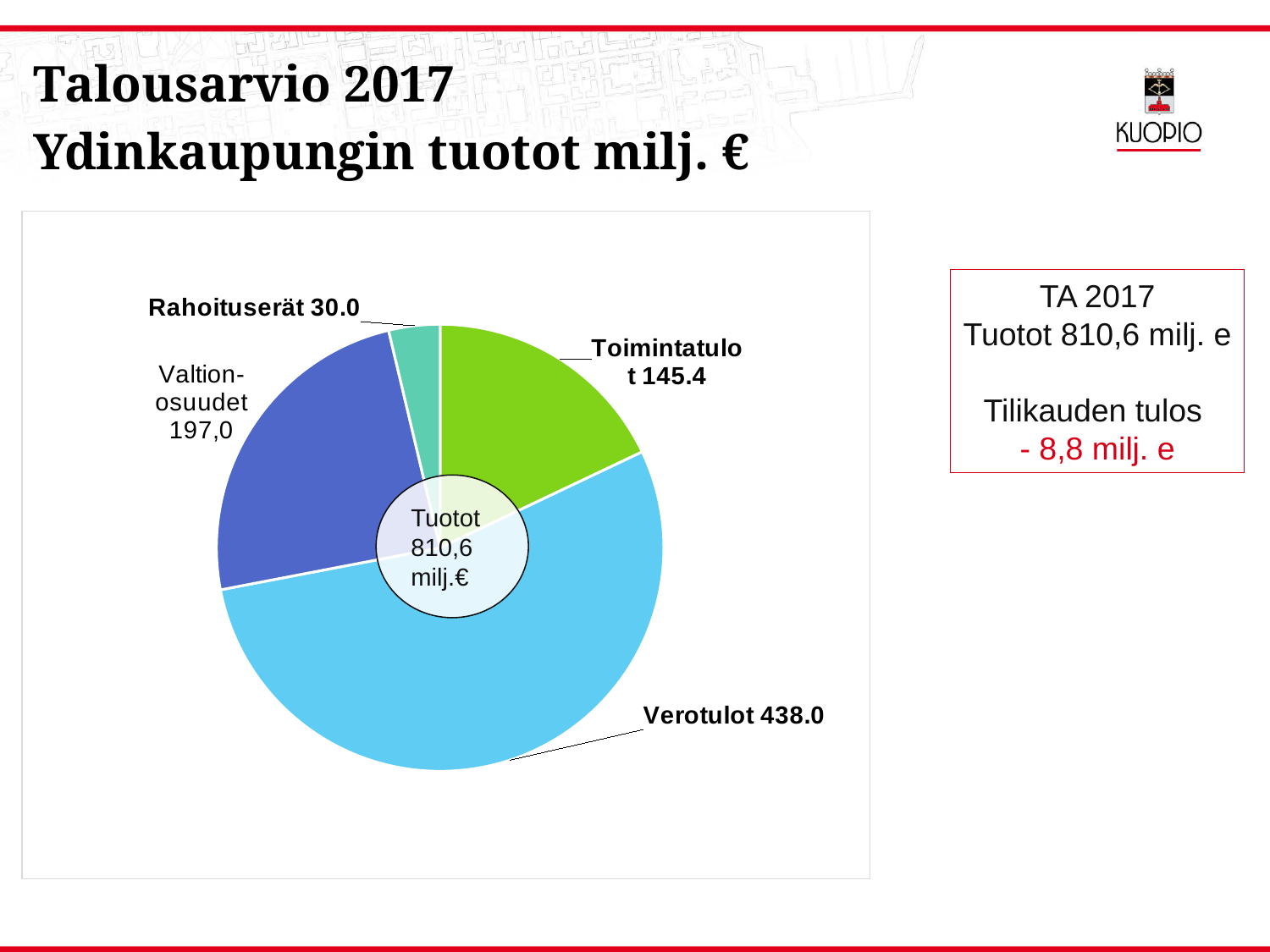
What total is printed in the centre of the pie chart? Tuotot 810,6 milj.€ How many slices does the pie chart have? 4 What is the value for Toimintatulot in the pie chart? 145.4 What is the value for Rahoituserät in the pie chart? 30.0 What is the value for Verotulot in the pie chart? 438.0 What is the difference between the values for Verotulot and Valtionosuudet? 241.0 Which is larger in the pie chart, Valtionosuudet or Toimintatulot? Valtionosuudet What is the value for Valtionosuudet in the pie chart? 197,0 Which slice of the pie chart is the smallest? Rahoituserät What is the difference between the values for Toimintatulot and Rahoituserät? 115.4 What kind of chart is shown on the slide? pie chart Which slice of the pie chart is the largest? Verotulot